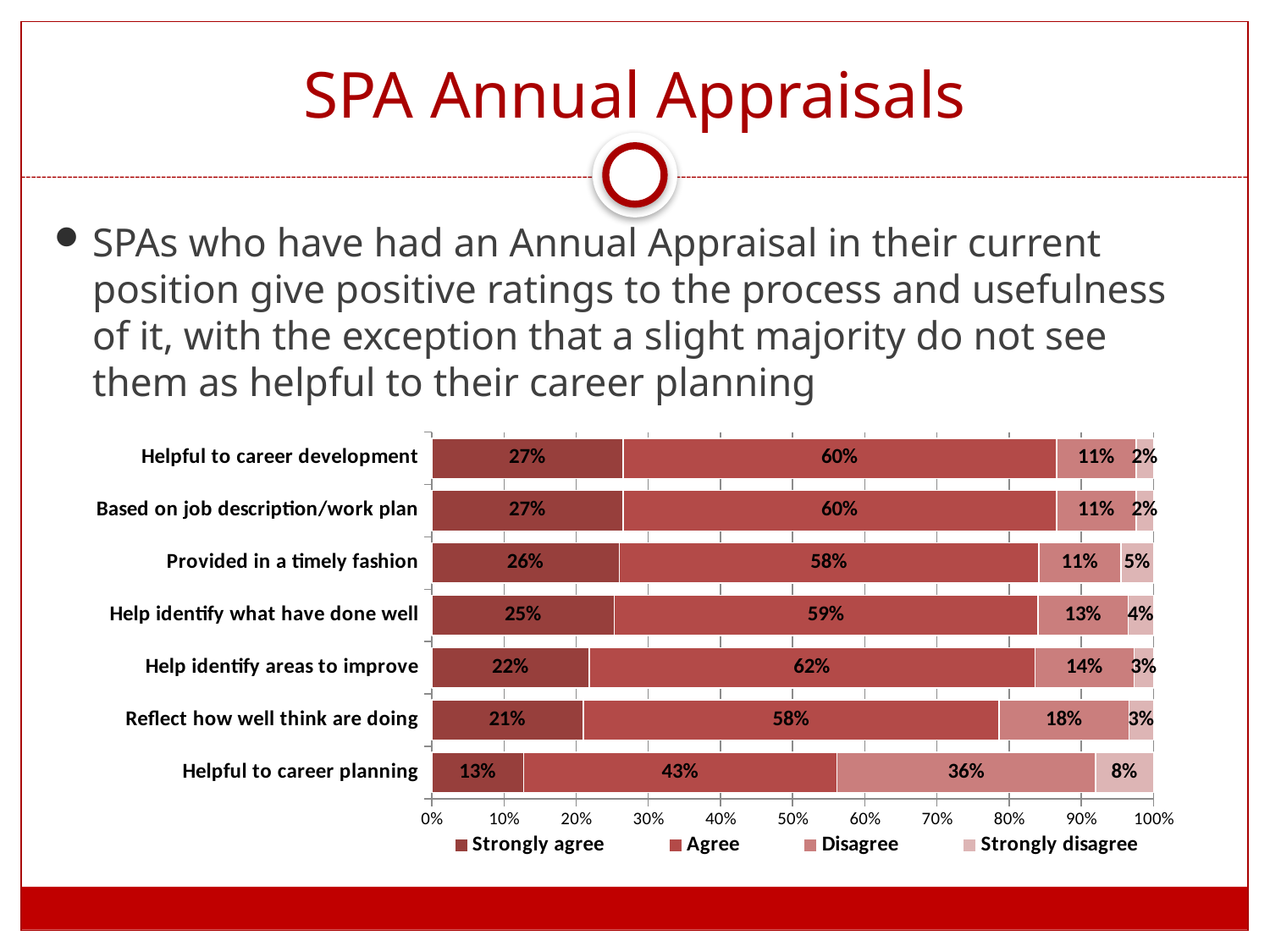
What kind of chart is shown on the slide? Stacked bar chart How many categories are shown on the chart? 7 What percentage of SPAs strongly disagree that annual appraisals are provided in a timely fashion? 5% What is the difference between the Agree percentage for 'Helpful to career development' and for 'Helpful to career planning'? 17% How many series does the legend list? 4 What percentage of SPAs agree that annual appraisals help identify areas to improve? 62% Which is larger: the Disagree percentage for 'Help identify what have done well' or for 'Help identify areas to improve'? Help identify areas to improve Which category has the highest Disagree percentage? Helpful to career planning What percentage of SPAs disagree that annual appraisals reflect how well they think they are doing? 18% Which category has the lowest Strongly agree percentage? Helpful to career planning What is the combined Strongly agree and Agree percentage for 'Helpful to career planning'? 56% What percentage of SPAs strongly agree that annual appraisals are helpful to career planning? 13%